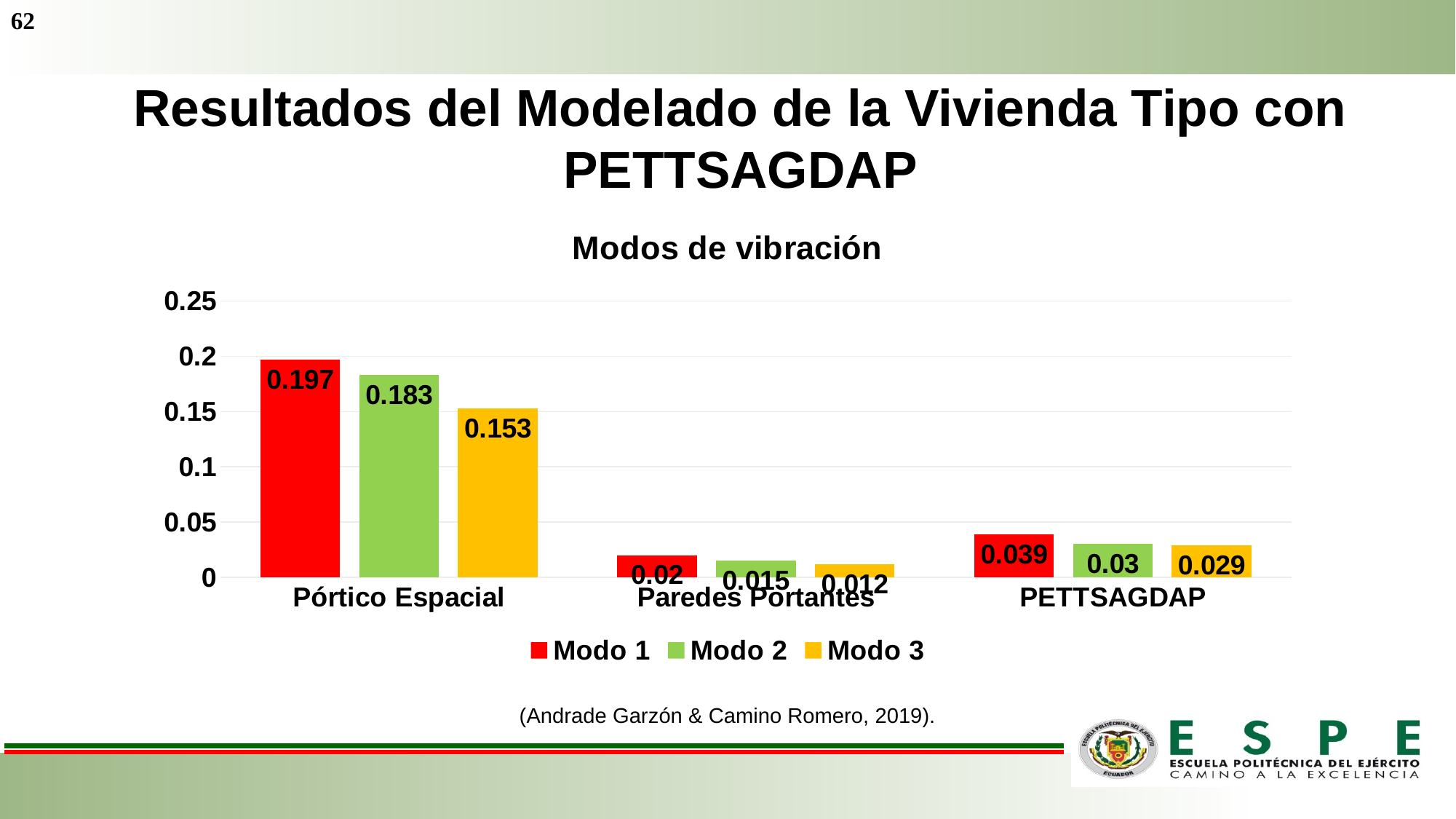
What is the difference between the Modo 1 values for PETTSAGDAP and Paredes Portantes? 0.019 How many series does the legend list? 3 What is the Modo 3 value for PETTSAGDAP? 0.029 What is the difference between the Modo 1 and Modo 3 values for Pórtico Espacial? 0.044 What is the Modo 2 value for Paredes Portantes? 0.015 Is the Modo 2 value for Pórtico Espacial greater or less than 0.15? greater How many categories are shown on the x axis? 3 What is the Modo 1 value for Pórtico Espacial? 0.197 Which category has the lowest Modo 3 value? Paredes Portantes What type of chart is shown on the slide? Bar chart Which is larger: the Modo 2 value for PETTSAGDAP or the Modo 2 value for Paredes Portantes? PETTSAGDAP Which category has the highest Modo 1 value? Pórtico Espacial